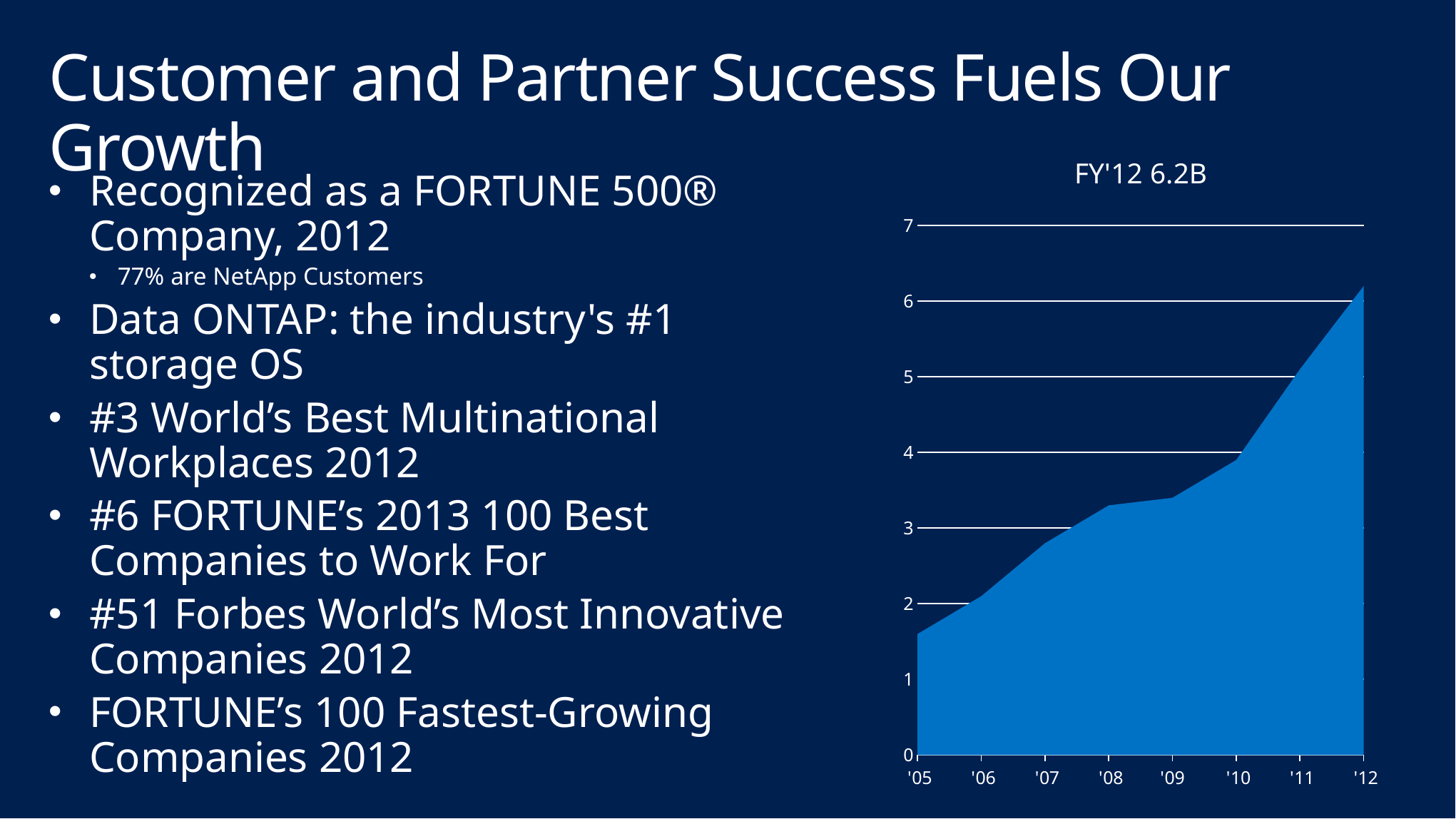
Is the value for '07 greater or less than 2? greater Is the value for '11 greater or less than 4? greater Is the value for '05 greater or less than 2? less How many years are shown on the x axis of the chart? 8 Do the values in the chart rise or fall from '05 to '12? rise What is the title of the chart? FY'12 6.2B Which year has the highest value in the chart? '12 Which year has the larger value, '06 or '10? '10 Which year has the lowest value in the chart? '05 What kind of chart is shown on the slide? area chart